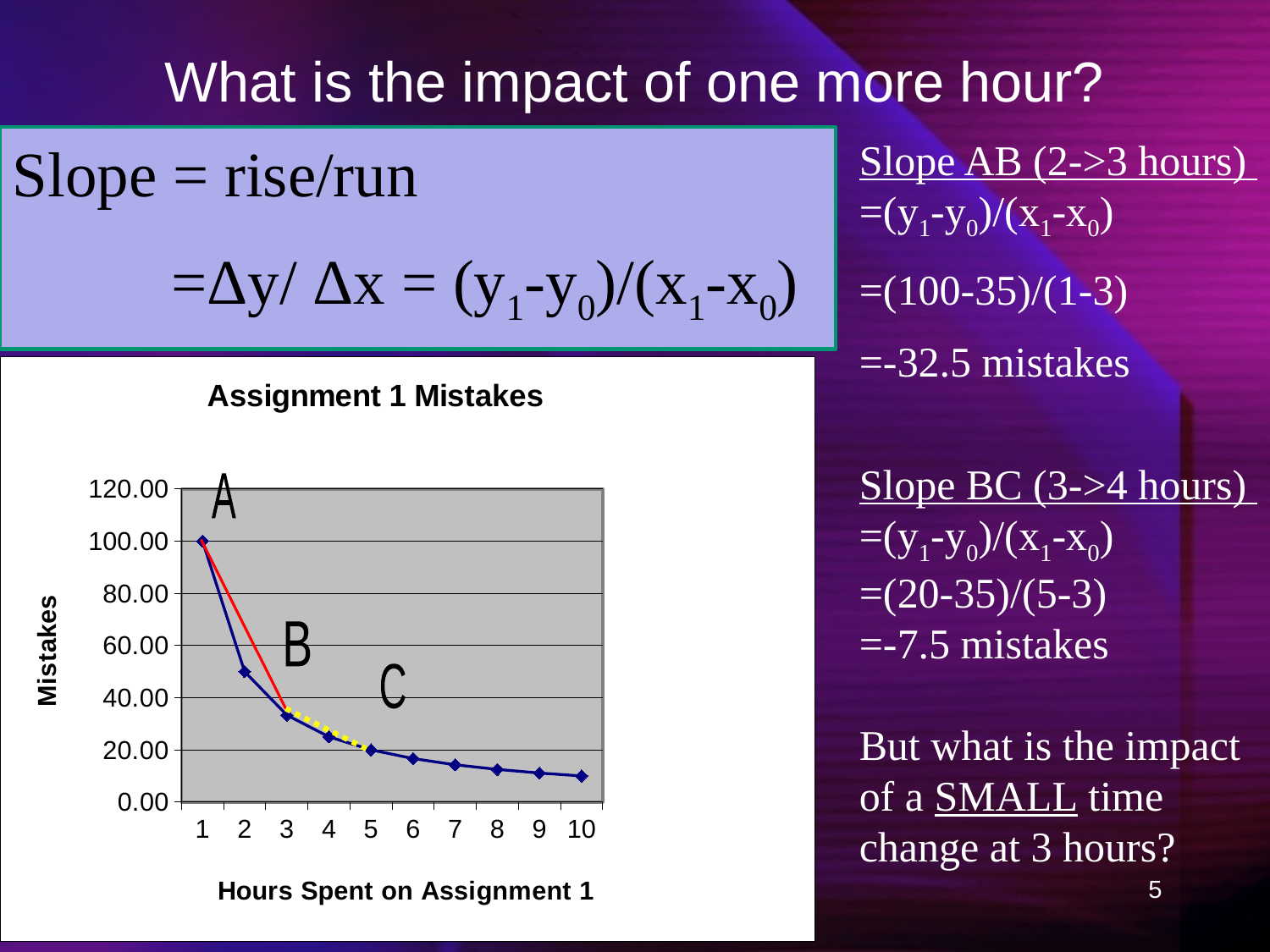
Which has more mistakes, 2 hours or 6 hours? 2 hours Do the mistakes rise or fall as the hours spent increase along the x axis? fall What type of chart is shown on the slide? line chart What is the number of mistakes at 5 hours spent on Assignment 1? 20.00 What is the label of the x axis of the chart? Hours Spent on Assignment 1 Is the value for 3 hours greater or less than 40.00? less How many data points are plotted on the chart? 10 What is the title of the chart? Assignment 1 Mistakes What is the number of mistakes at 1 hour spent on Assignment 1? 100.00 Is the value for 10 hours greater or less than 20.00? less Is the value for 2 hours greater or less than 40.00? greater At which number of hours is the number of mistakes highest? 1